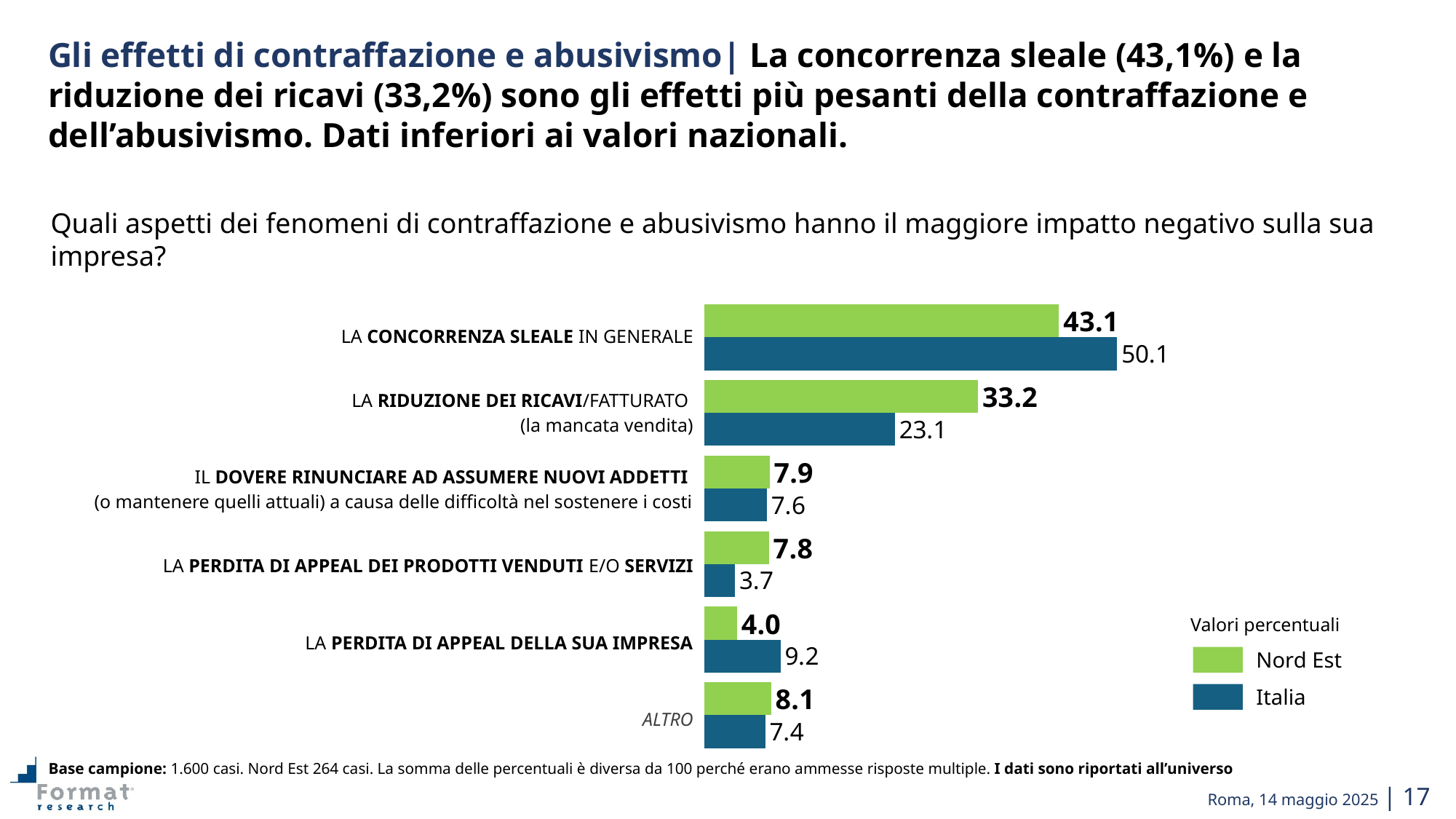
What is the Italia value for 'LA PERDITA DI APPEAL DELLA SUA IMPRESA'? 9.2 What is the Italia value for 'LA RIDUZIONE DEI RICAVI/FATTURATO'? 23.1 For 'LA PERDITA DI APPEAL DEI PRODOTTI VENDUTI E/O SERVIZI', which series has the larger value, Nord Est or Italia? Nord Est How many categories are shown in the chart? 6 Which colour represents the Italia series in the chart? Dark blue How many series does the legend list? 2 What is the difference between the Italia and Nord Est values for 'LA CONCORRENZA SLEALE IN GENERALE'? 7.0 Which category has the lowest Nord Est value? LA PERDITA DI APPEAL DELLA SUA IMPRESA What kind of chart is shown on the slide? Bar chart What is the Nord Est value for 'ALTRO'? 8.1 Which category has the highest Italia value? LA CONCORRENZA SLEALE IN GENERALE What is the Nord Est value for 'LA CONCORRENZA SLEALE IN GENERALE'? 43.1